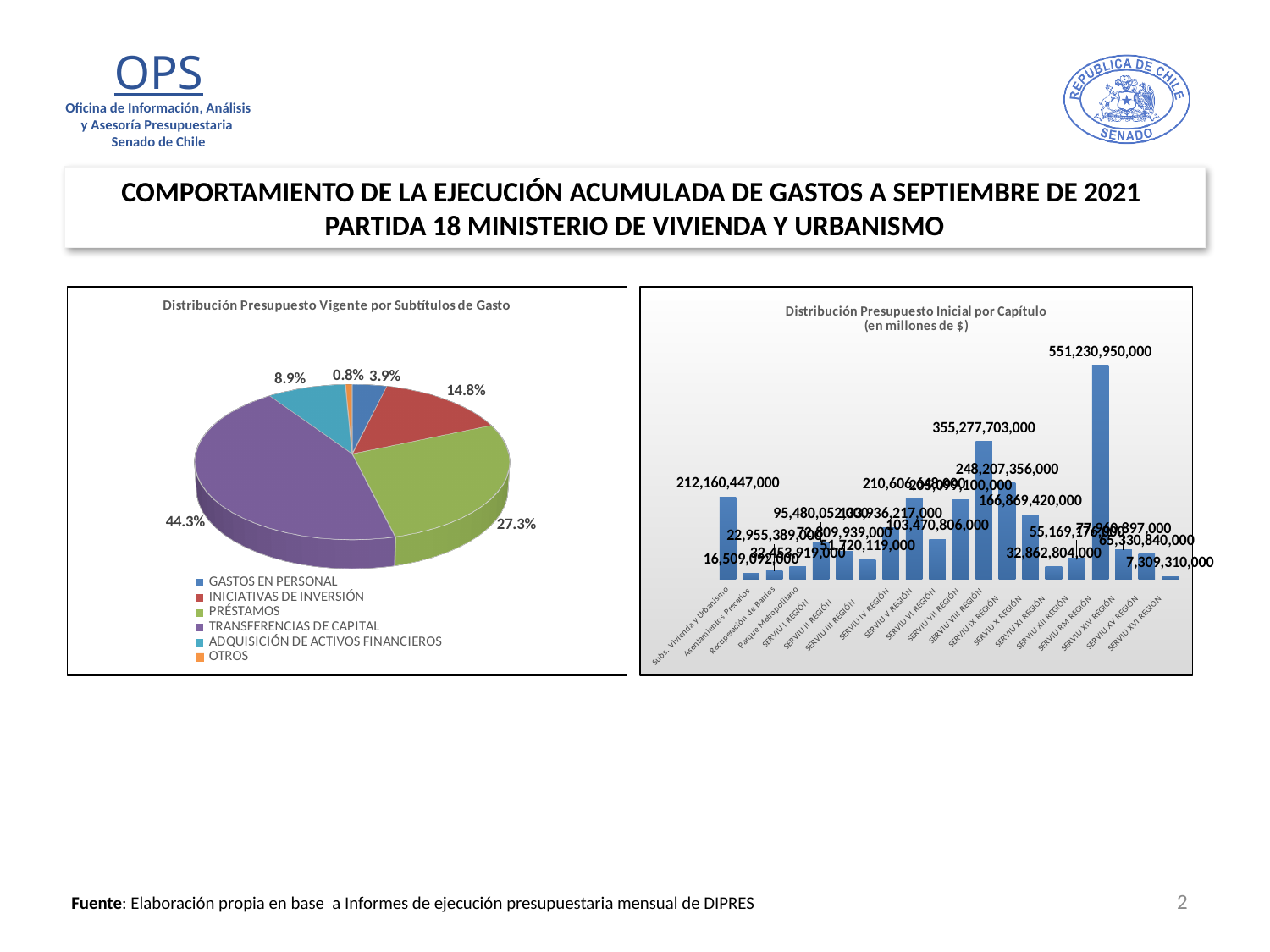
In the pie chart 'Distribución Presupuesto Vigente por Subtítulos de Gasto', what share does TRANSFERENCIAS DE CAPITAL have? 44.3% In the pie chart 'Distribución Presupuesto Vigente por Subtítulos de Gasto', which category has the smallest slice? OTROS In the bar chart 'Distribución Presupuesto Inicial por Capítulo', which category has the highest value? SERVIU RM REGIÓN How many categories does the legend of the pie chart 'Distribución Presupuesto Vigente por Subtítulos de Gasto' list? 6 In the bar chart 'Distribución Presupuesto Inicial por Capítulo', which is larger: Subs. Vivienda y Urbanismo or SERVIU X REGIÓN? Subs. Vivienda y Urbanismo What kind of chart is the right chart, 'Distribución Presupuesto Inicial por Capítulo'? Bar chart In the pie chart 'Distribución Presupuesto Vigente por Subtítulos de Gasto', which category has the largest slice? TRANSFERENCIAS DE CAPITAL In the bar chart 'Distribución Presupuesto Inicial por Capítulo', what is the value for SERVIU IX REGIÓN? 248,207,356,000 What kind of chart is the left chart, 'Distribución Presupuesto Vigente por Subtítulos de Gasto'? Pie chart In the bar chart 'Distribución Presupuesto Inicial por Capítulo', which category has the lowest value? SERVIU XVI REGIÓN In the pie chart 'Distribución Presupuesto Vigente por Subtítulos de Gasto', what is the difference in percentage points between PRÉSTAMOS and INICIATIVAS DE INVERSIÓN? 12.5 percentage points In the pie chart 'Distribución Presupuesto Vigente por Subtítulos de Gasto', what percentage is shown for PRÉSTAMOS? 27.3%